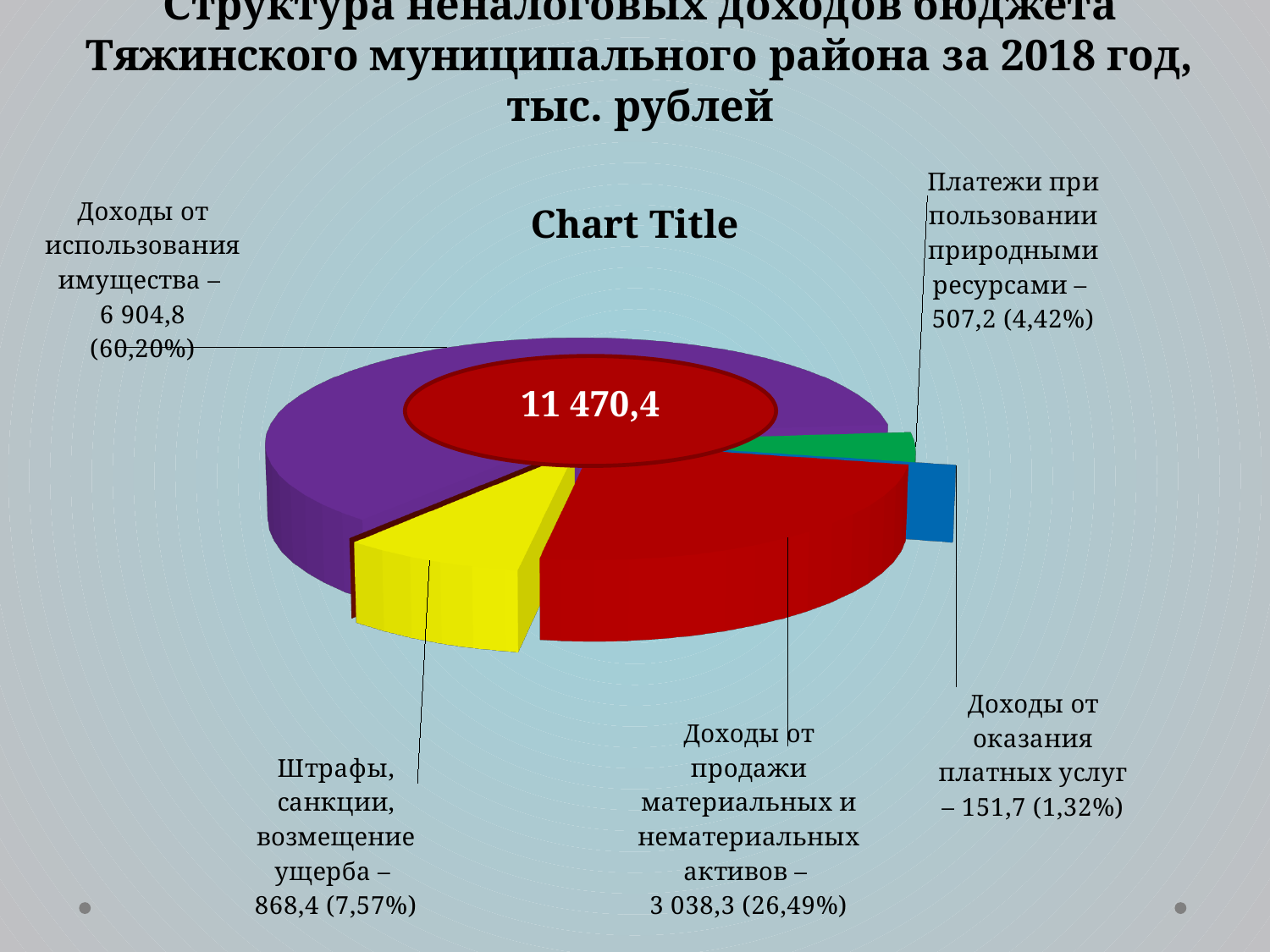
Which category has the smallest slice of the pie? Доходы от оказания платных услуг What total value is printed in the centre of the pie chart? 11 470,4 What share of the pie does «Штрафы, санкции, возмещение ущерба» represent? 7,57% Which is larger: «Штрафы, санкции, возмещение ущерба» or «Платежи при пользовании природными ресурсами»? Штрафы, санкции, возмещение ущерба Which category has the largest slice of the pie? Доходы от использования имущества What kind of chart is shown on the slide? pie chart What is the value for «Доходы от использования имущества»? 6 904,8 What is the value for «Платежи при пользовании природными ресурсами»? 507,2 What share of the pie does «Доходы от использования имущества» represent? 60,20% What is the value for «Доходы от продажи материальных и нематериальных активов»? 3 038,3 How many slices does the pie chart have? 5 What is the difference between the values for «Доходы от использования имущества» and «Доходы от продажи материальных и нематериальных активов»? 3 866,5